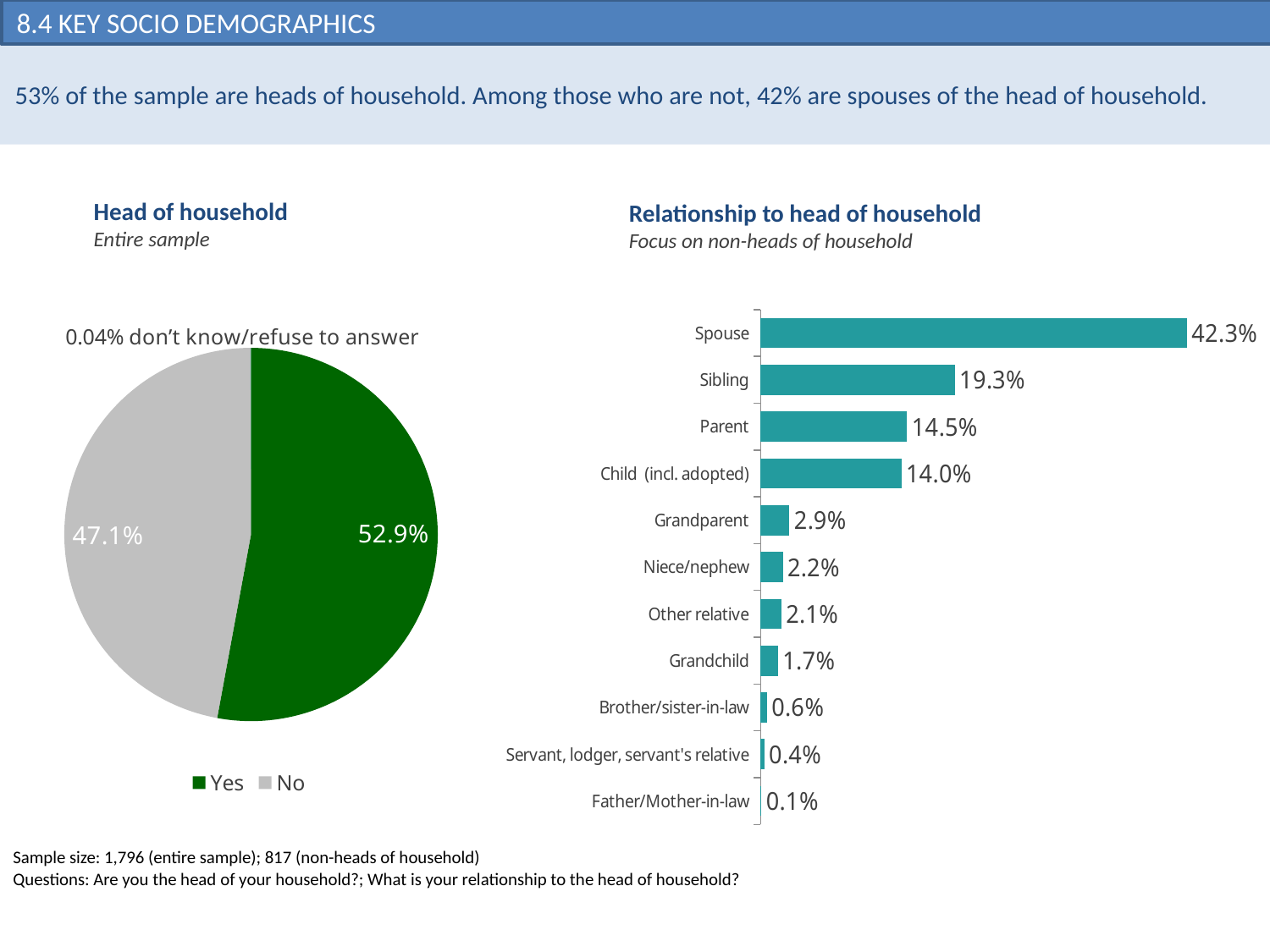
In the 'Relationship to head of household' chart, which category has the lowest value? Father/Mother-in-law What kind of chart is the 'Relationship to head of household' chart? Bar chart In the 'Relationship to head of household' chart, which category has the highest value? Spouse In the 'Relationship to head of household' chart, how many categories are shown? 11 How many entries does the legend of the 'Head of household' pie chart list? 2 In the 'Head of household' pie chart, what share of the sample answered No? 47.1% In the 'Relationship to head of household' chart, what is the difference between Sibling and Parent? 4.8% What kind of chart is the 'Head of household' chart? Pie chart In the 'Head of household' pie chart, what is the difference between the Yes and No shares? 5.8% In the 'Relationship to head of household' chart, what is the value for Child (incl. adopted)? 14.0% In the 'Relationship to head of household' chart, what is the value for Spouse? 42.3% In the 'Head of household' pie chart, what share of the sample answered Yes? 52.9%